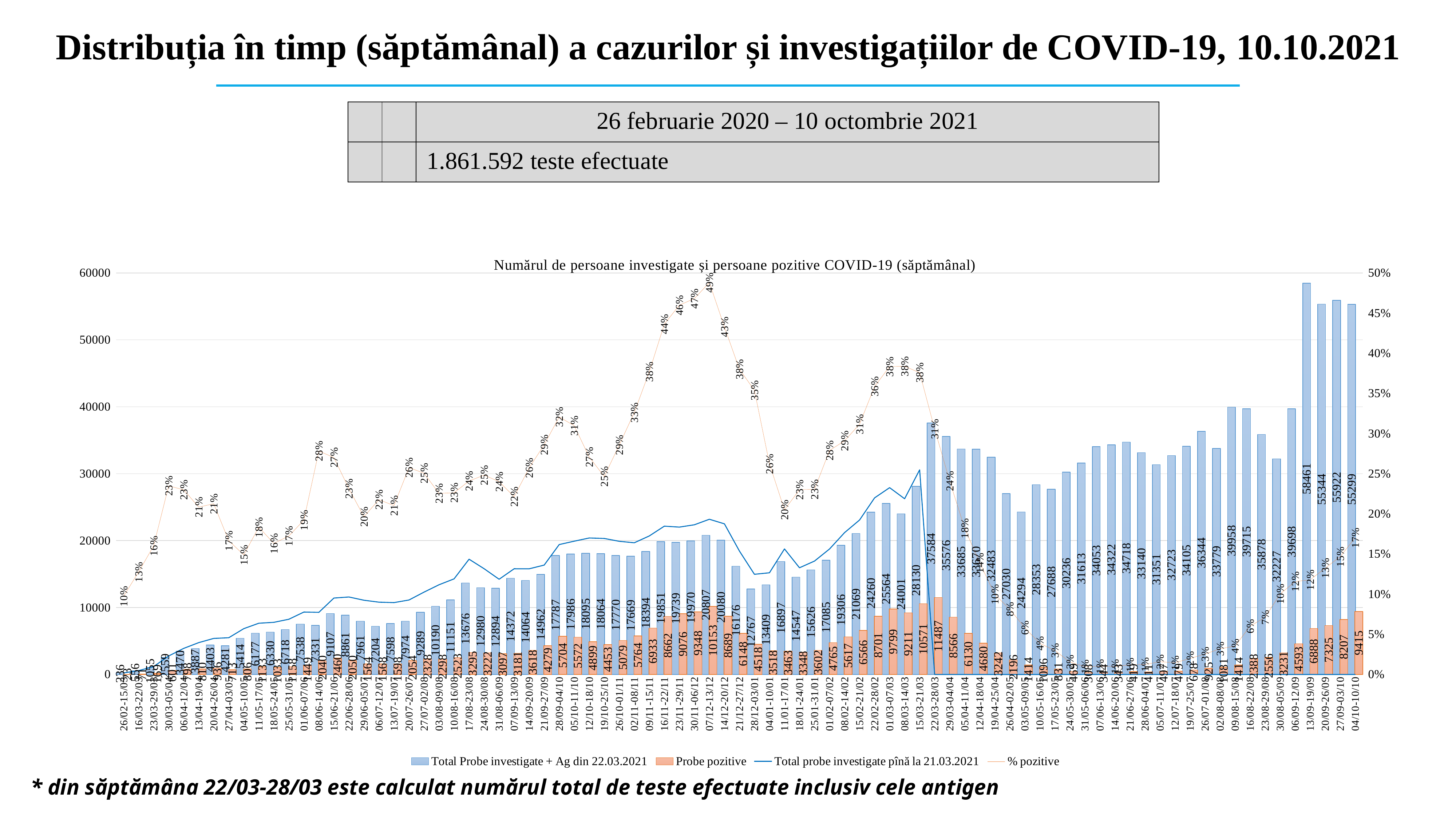
Does the '% pozitive' value rise or fall from the week 19/04-25/04 to the week 17/05-23/05? fall What is the difference between the 'Total Probe investigate + Ag' values for 13/09-19/09 and 20/09-26/09? 3117 How many series does the chart legend list? 4 What kind of chart is used to show the weekly number of investigated and positive persons? bar chart (with line series) What is the title of the chart? Numărul de persoane investigate și persoane pozitive COVID-19 (săptămânal) Is the 'Total Probe investigate + Ag' value for 06/09-12/09 greater or less than 50000? less Which is larger: the 'Probe pozitive' value for 22/03-28/03 or for 29/03-04/04? 22/03-28/03 What is the value of 'Total Probe investigate + Ag' for the week 13/09-19/09? 58461 Which week has the highest '% pozitive' value? 07/12-13/12 What is the value of 'Probe pozitive' for the week 04/10-10/10? 9415 What is the '% pozitive' value for the week 07/12-13/12? 49% Which week has the highest 'Total Probe investigate + Ag' bar? 13/09-19/09